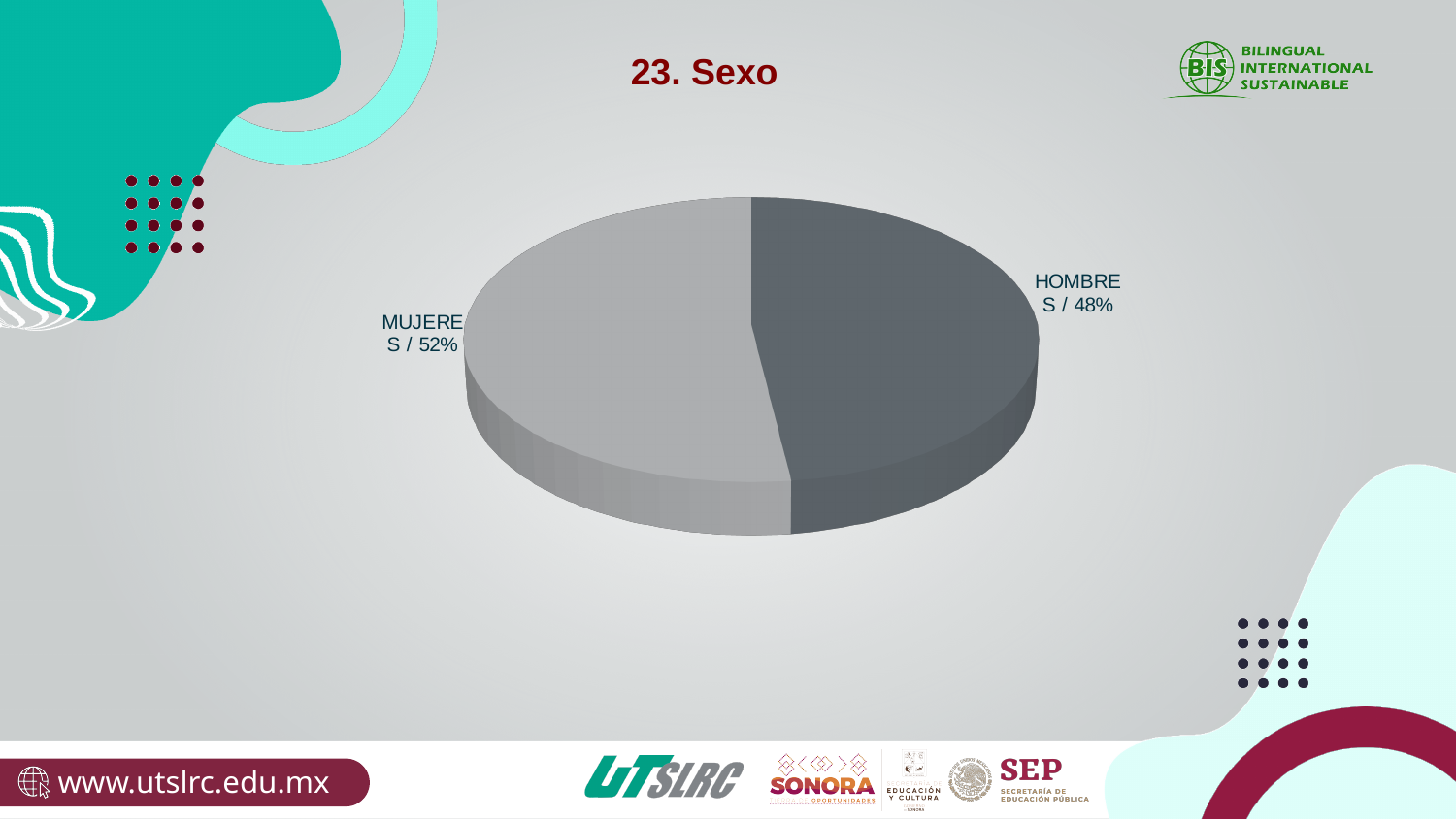
Which is larger, the MUJERES slice or the HOMBRES slice? MUJERES What is the difference in percentage points between the MUJERES and HOMBRES slices? 4 Which slice is the largest? MUJERES How many slices does the pie chart have? 2 Which slice is shown in the darker grey colour? HOMBRES What percentage of the pie is labelled MUJERES? 52% What kind of chart is shown on the slide? pie chart What percentage of the pie is labelled HOMBRES? 48% Is the share for HOMBRES greater or less than 50%? less Which slice is the smallest? HOMBRES What is the title of the chart? 23. Sexo